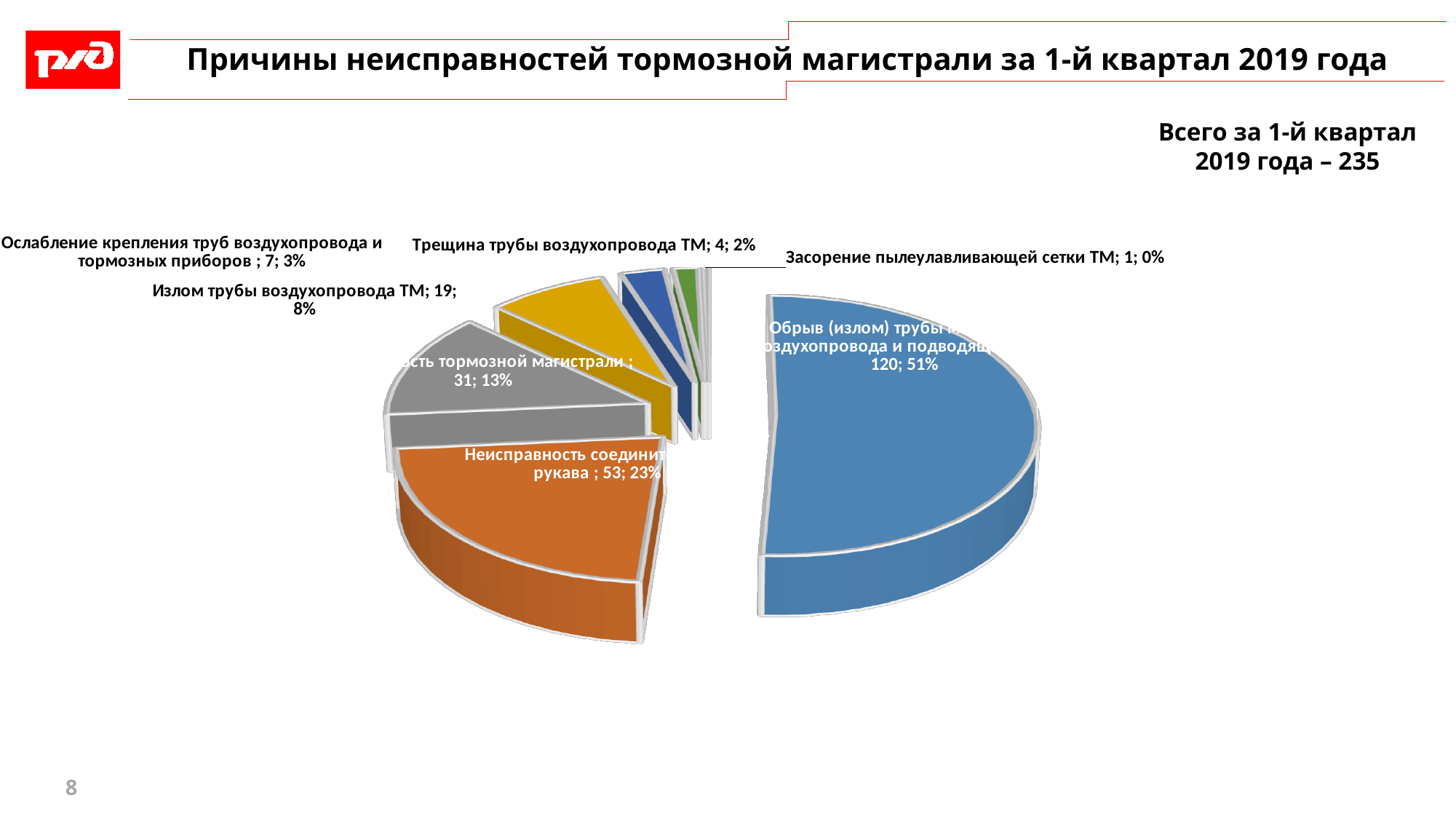
What total for the 1st quarter of 2019 is stated on the slide? 235 What is the value for "Засорение пылеулавливающей сетки ТМ"? 1 What is the value for "Излом трубы воздухопровода ТМ"? 19 What share of the pie does "Ослабление крепления труб воздухопровода и тормозных приборов" represent? 3% What share of the pie does "Излом трубы воздухопровода ТМ" represent? 8% Which category has the largest slice of the pie? Обрыв (излом) трубы воздухопровода Which category has the smallest slice of the pie? Засорение пылеулавливающей сетки ТМ What is the difference between the values for "Излом трубы воздухопровода ТМ" and "Трещина трубы воздухопровода ТМ"? 15 Which is larger: the value for "Ослабление крепления труб воздухопровода и тормозных приборов" or for "Трещина трубы воздухопровода ТМ"? Ослабление крепления труб воздухопровода и тормозных приборов What is the value for "Трещина трубы воздухопровода ТМ"? 4 What kind of chart is shown on the slide? Pie chart How many slices does the pie chart have? 7